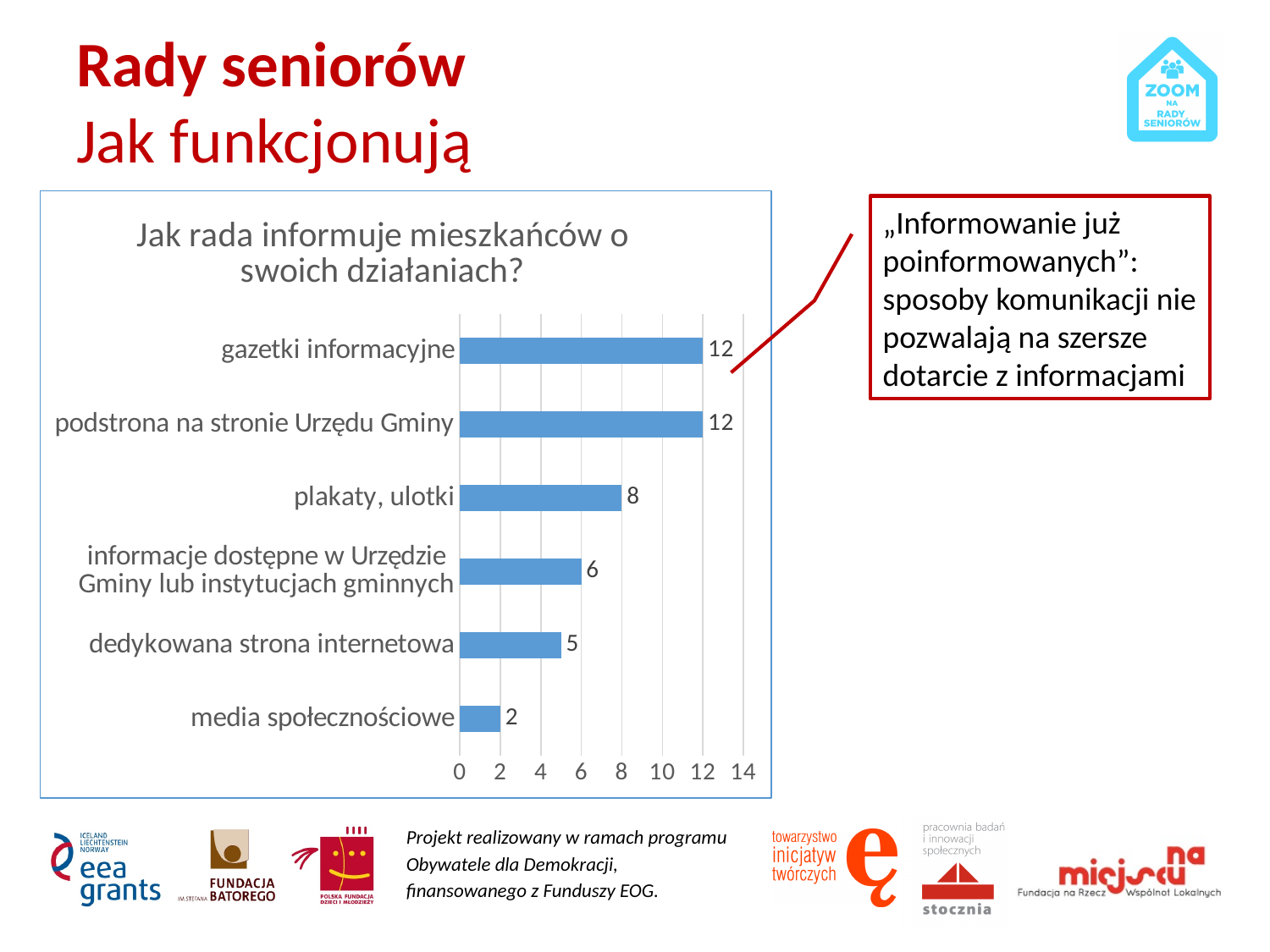
Which is larger: the value for "plakaty, ulotki" or the value for "dedykowana strona internetowa"? plakaty, ulotki What is the difference between the values for "gazetki informacyjne" and "plakaty, ulotki"? 4 What is the value for "dedykowana strona internetowa"? 5 How many categories are shown in the chart? 6 What is the value for "media społecznościowe"? 2 Is the value for "podstrona na stronie Urzędu Gminy" greater or less than 10? greater What is the value for "informacje dostępne w Urzędzie Gminy lub instytucjach gminnych"? 6 What is the title of the chart? Jak rada informuje mieszkańców o swoich działaniach? What is the value for "plakaty, ulotki"? 8 Which category has the lowest value? media społecznościowe What kind of chart is shown on the slide? bar chart What is the difference between the values for "dedykowana strona internetowa" and "media społecznościowe"? 3